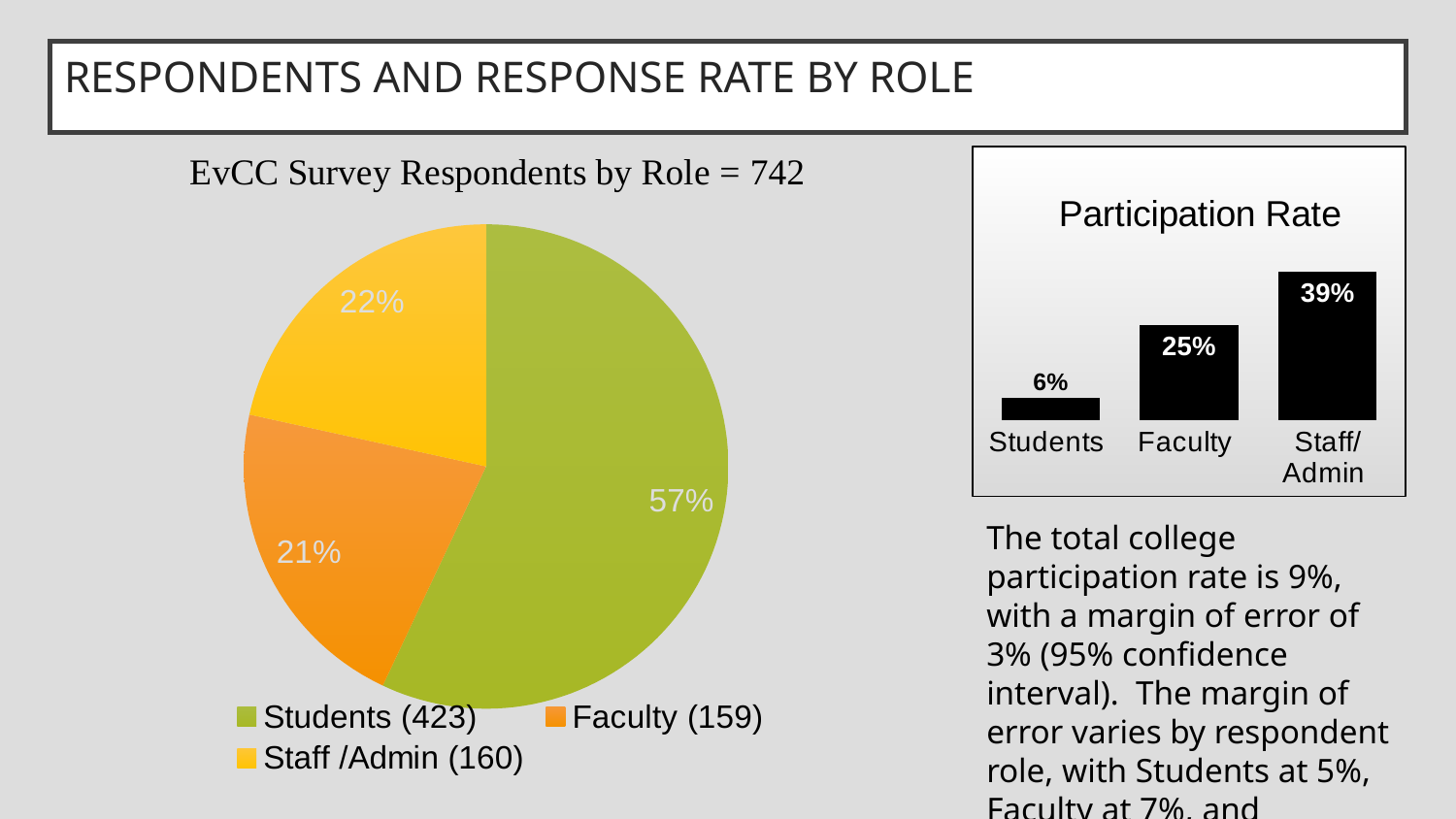
In the Participation Rate chart, what is the participation rate for Faculty? 25% In the EvCC Survey Respondents by Role pie chart, what share of respondents are Faculty? 21% In the Participation Rate chart, which role has the lowest participation rate? Students In the Participation Rate chart, how many roles are shown? 3 In the EvCC Survey Respondents by Role pie chart, which role has the largest slice? Students In the EvCC Survey Respondents by Role pie chart, how many respondents are Staff/Admin according to the legend? 160 In the Participation Rate chart, what is the difference between the Staff/Admin and Faculty participation rates? 14% What kind of chart is the Participation Rate chart? Bar chart In the EvCC Survey Respondents by Role pie chart, what share of respondents are Students? 57% What kind of chart is the EvCC Survey Respondents by Role chart? Pie chart In the Participation Rate chart, which role has the highest participation rate? Staff/Admin In the Participation Rate chart, what is the participation rate for Students? 6%